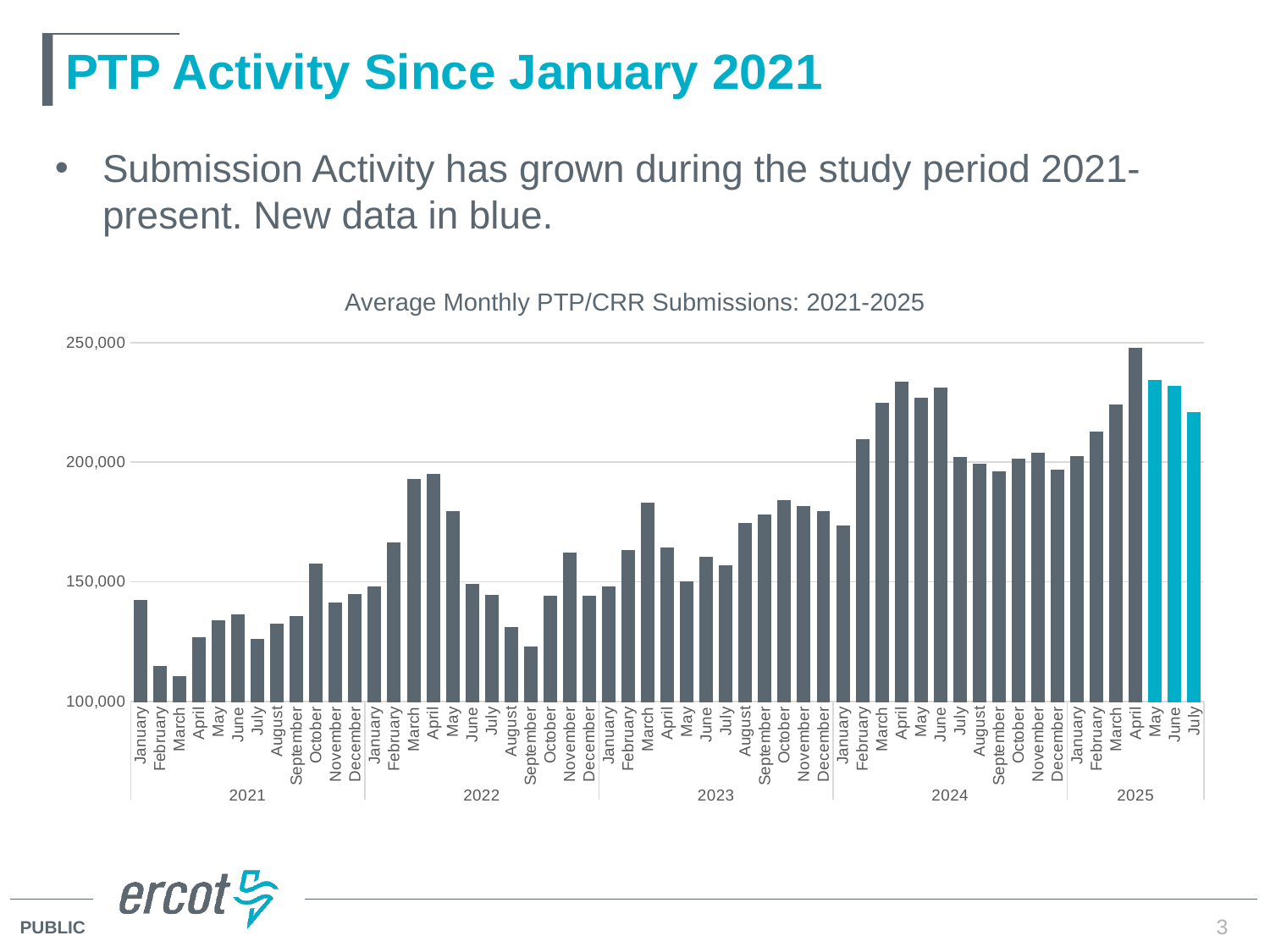
Is the value for March 2021 greater or less than 150,000? less What type of chart is shown on the slide? Bar chart Is the value for April 2025 greater or less than 200,000? greater Is the value for January 2024 greater or less than 200,000? less Which month has the highest value in the chart? April 2025 Which is larger, the value for April 2025 or the value for April 2024? April 2025 How many bars are shown in the chart? 55 How many bars are coloured blue (new data)? 3 What is the title of the chart? Average Monthly PTP/CRR Submissions: 2021-2025 Overall, do the values rise or fall from 2021 to 2025? Rise